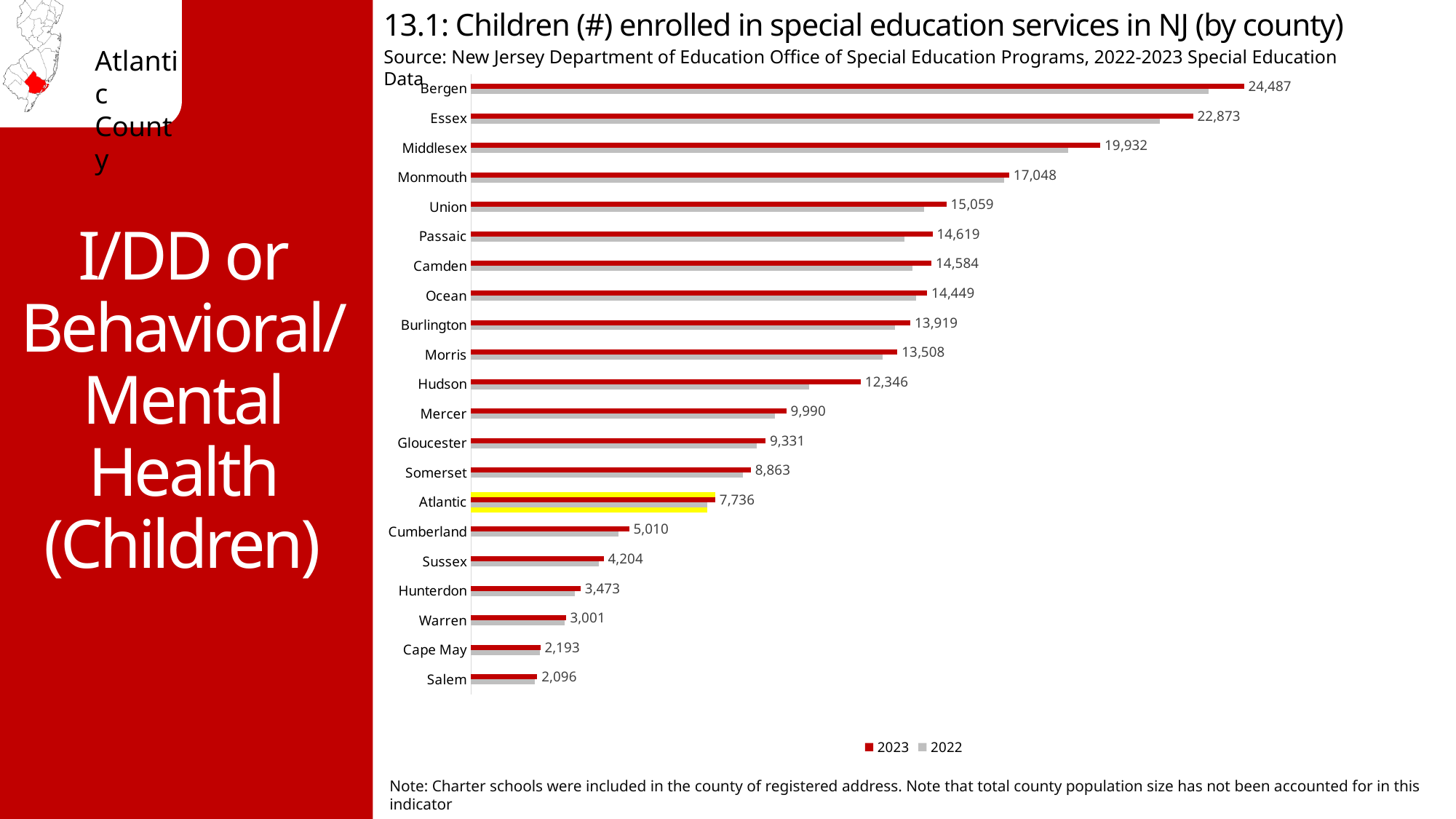
What is the 2023 value for Atlantic county? 7,736 Which county has the highest 2023 value? Bergen What is the difference between the 2023 values for Atlantic and Cumberland? 2,726 Which county has the lowest 2023 value? Salem Which series is shown in red in the legend? 2023 What kind of chart is shown on the slide? bar chart What is the difference between the 2023 values for Bergen and Essex? 1,614 How many counties are shown in the chart? 21 Which county has a larger 2023 value, Hudson or Mercer? Hudson What is the 2023 value for Bergen county? 24,487 How many series does the legend list? 2 What is the 2023 value for Cumberland county? 5,010